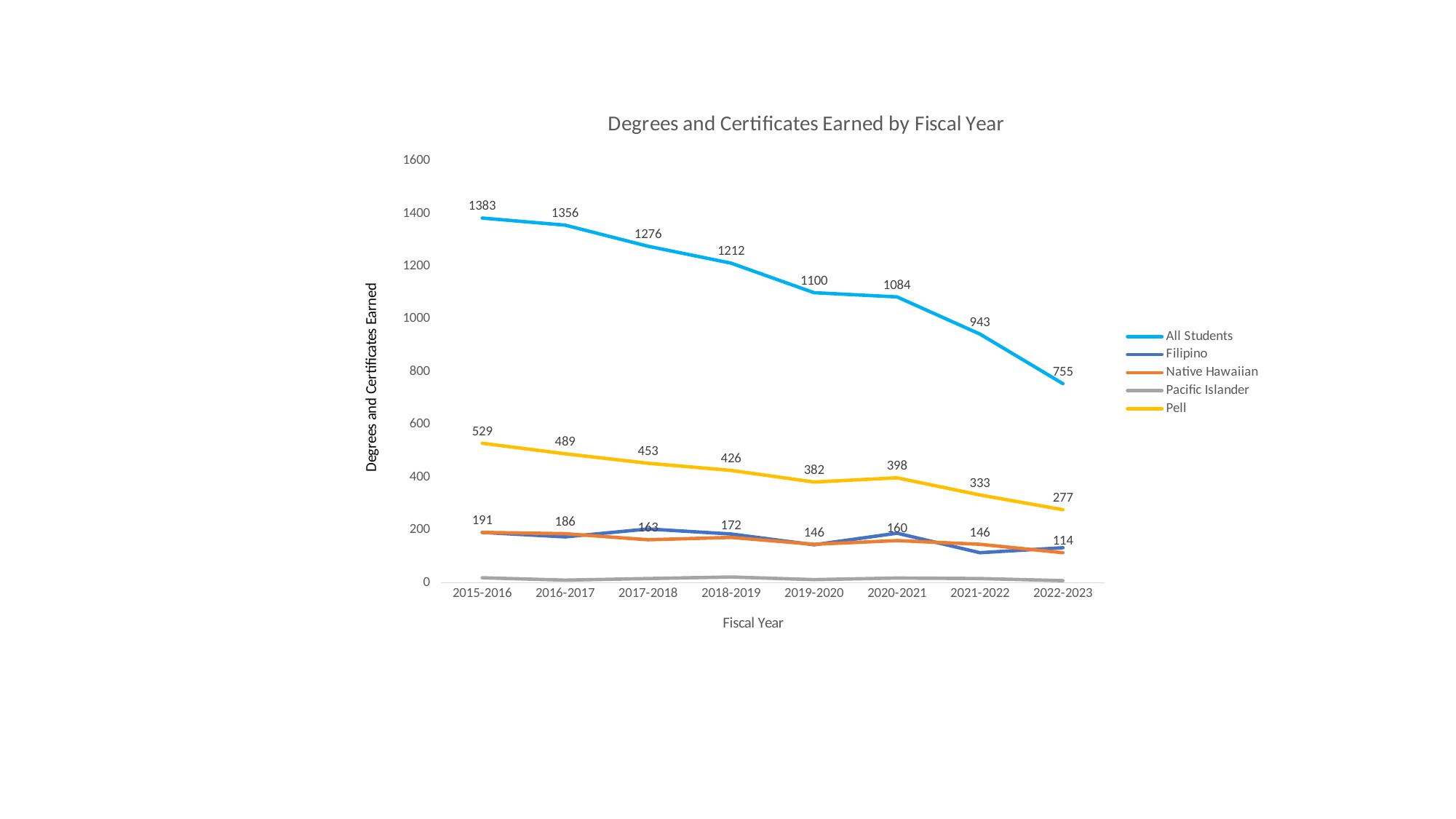
Is the value for Pacific Islander in 2018-2019 greater or less than 200? less What kind of chart is shown on the slide? line chart What is the value for Pell in 2019-2020? 382 How many fiscal years are shown on the x axis? 8 Which year has the larger Pell value, 2019-2020 or 2020-2021? 2020-2021 What is the value for All Students in 2022-2023? 755 Does the All Students line rise or fall from 2015-2016 to 2022-2023? falls In which fiscal year is the Pell value lowest? 2022-2023 How many series does the legend list? 5 What is the difference between the All Students values in 2015-2016 and 2022-2023? 628 What is the value for All Students in 2015-2016? 1383 In which fiscal year is the All Students value highest? 2015-2016